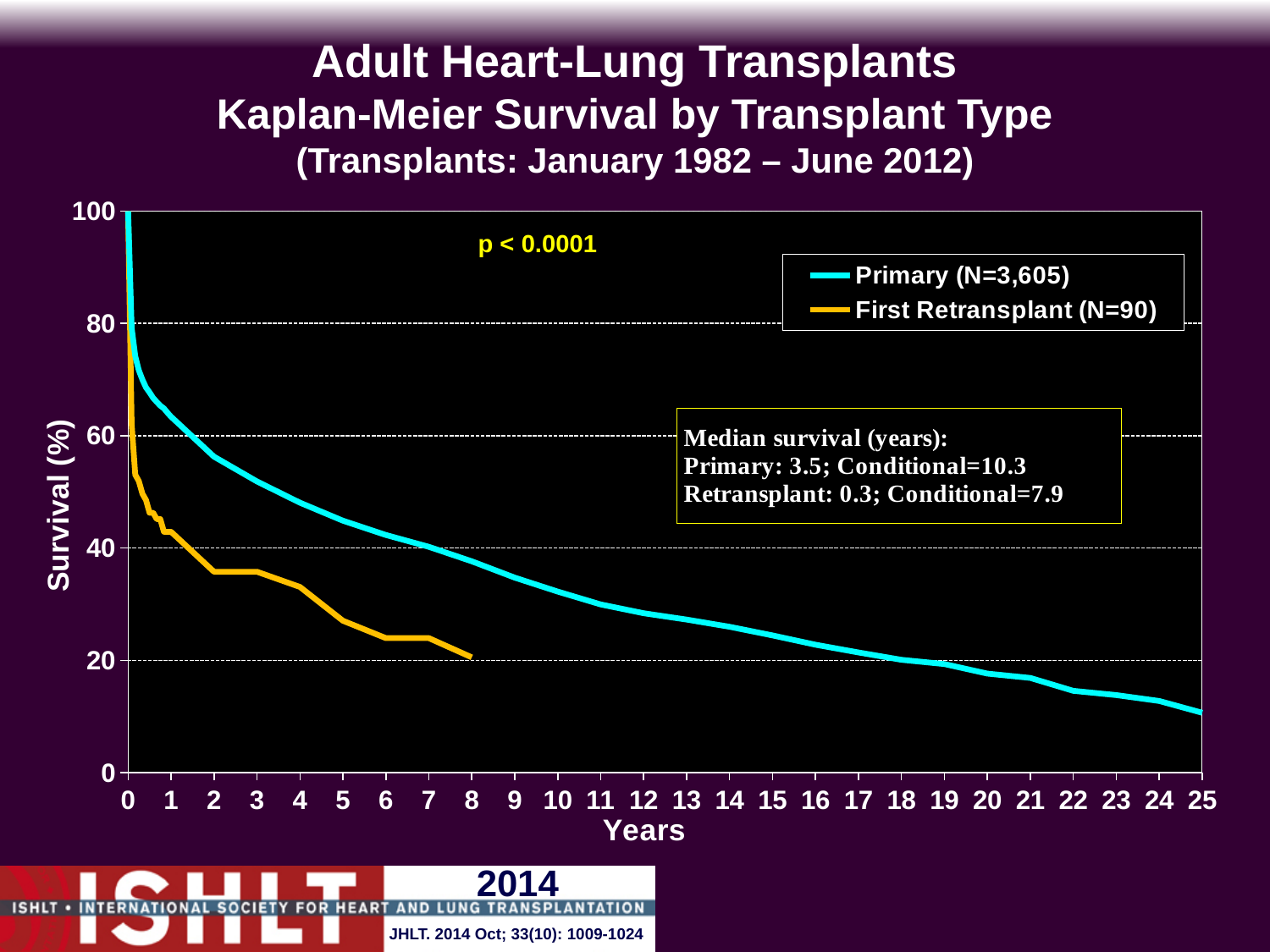
At 5 years, which group has higher survival, Primary or First Retransplant? Primary Do the survival curves rise or fall as years increase? Fall What is the number of patients (N) in the Primary group? 3,605 How many series does the legend list? 2 What is the median survival in years for the Primary group? 3.5 What is the number of patients (N) in the First Retransplant group? 90 Is the survival for the Primary group at 10 years greater or less than 40? less What is the conditional median survival in years for the Retransplant group? 7.9 Is the survival for the First Retransplant group at 5 years greater or less than 20? greater What kind of chart is shown on the slide? Line chart What is the median survival in years for the Retransplant group? 0.3 What is the conditional median survival in years for the Primary group? 10.3